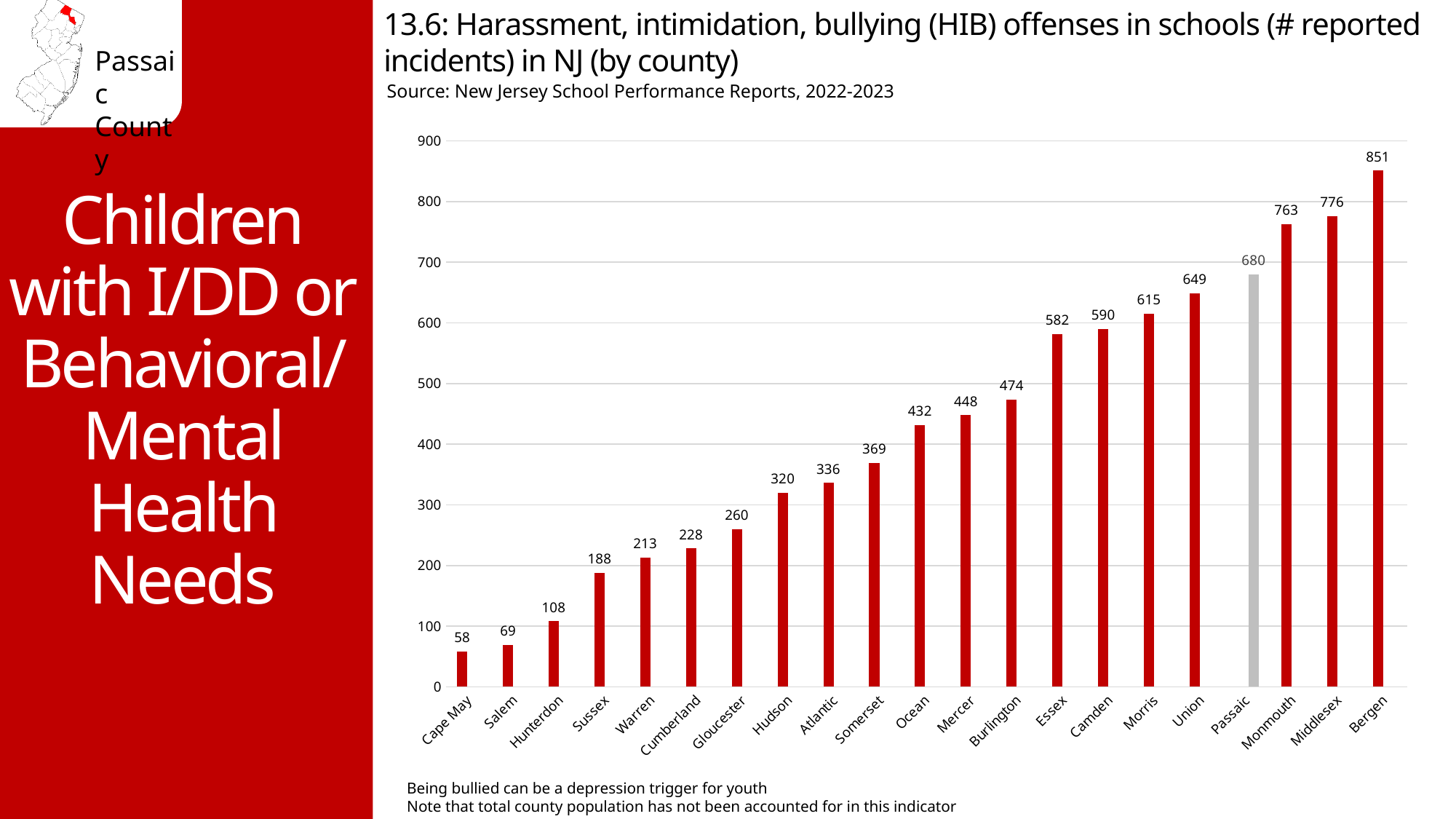
Which county's bar is shown in grey rather than red? Passaic Do the values rise or fall moving from left to right along the x axis? Rise What kind of chart is shown on the slide? Bar chart Is the value for Union greater or less than 600? greater Which county has the highest number of reported HIB incidents? Bergen Which county has more reported HIB incidents, Essex or Camden? Camden How many counties are shown on the chart? 21 What is the difference in reported HIB incidents between Middlesex and Monmouth? 13 Which county has the lowest number of reported HIB incidents? Cape May What is the number of reported HIB incidents for Hudson county? 320 What is the number of reported HIB incidents for Passaic county? 680 What is the difference in reported HIB incidents between Bergen and Passaic? 171